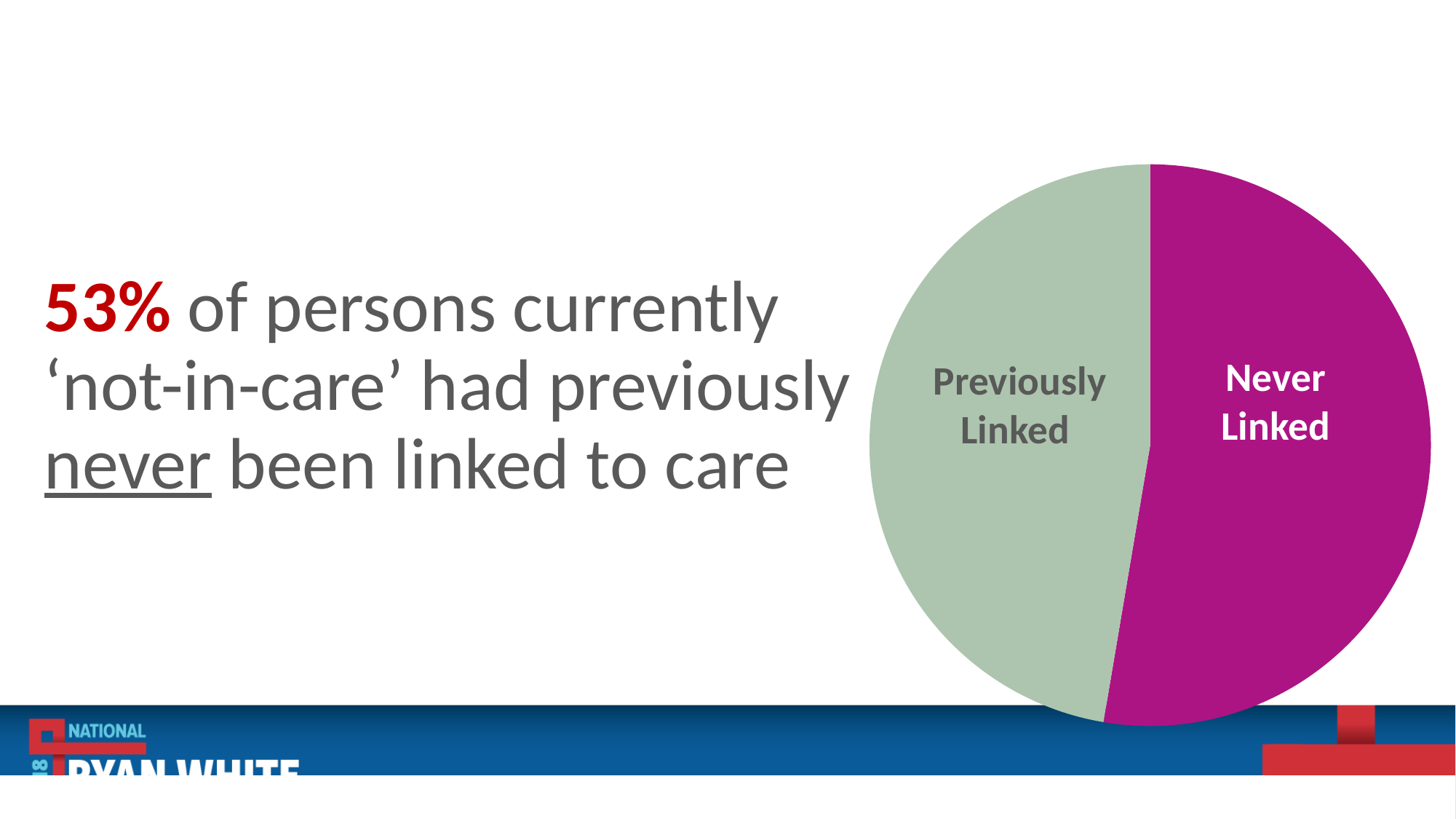
What share of the pie does the Never Linked slice represent? 53% How many slices does the pie chart have? 2 Which is larger in the pie chart, Never Linked or Previously Linked? Never Linked What kind of chart is shown on the slide? pie chart Which slice of the pie chart is the smallest? Previously Linked What colour is the Never Linked slice of the pie chart? magenta Which slice of the pie chart is the largest? Never Linked What are the labels of the two slices in the pie chart? Previously Linked and Never Linked